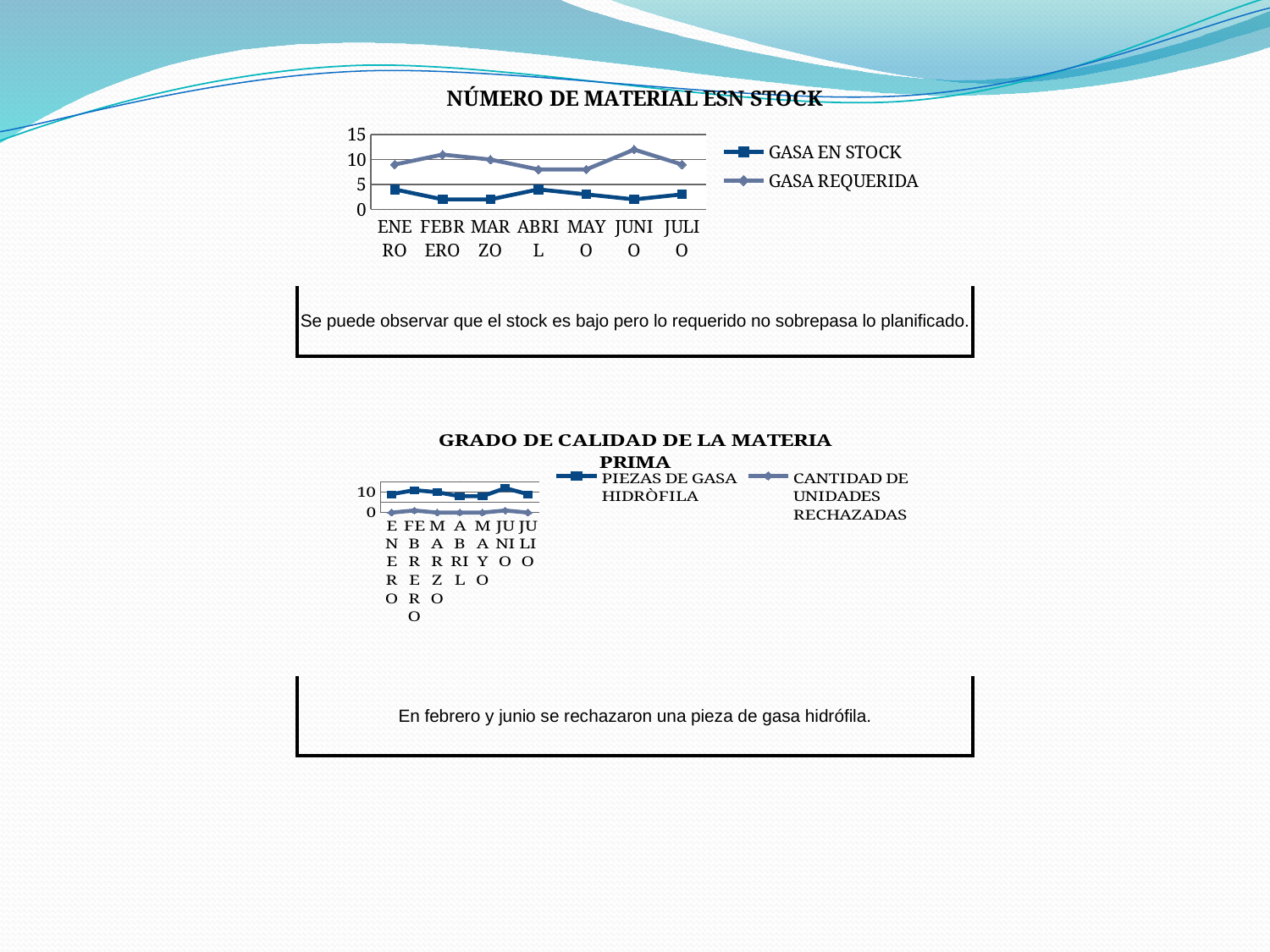
What kind of chart is the top chart titled 'NÚMERO DE MATERIAL ESN STOCK'? Line chart How many series does the legend of the top chart 'NÚMERO DE MATERIAL ESN STOCK' list? 2 In the top chart 'NÚMERO DE MATERIAL ESN STOCK', is the value of GASA EN STOCK in ENERO greater or less than 5? less In the bottom chart 'GRADO DE CALIDAD DE LA MATERIA PRIMA', which series has the larger value in ENERO, PIEZAS DE GASA HIDRÒFILA or CANTIDAD DE UNIDADES RECHAZADAS? PIEZAS DE GASA HIDRÒFILA In the top chart 'NÚMERO DE MATERIAL ESN STOCK', which series has the larger value in ENERO, GASA EN STOCK or GASA REQUERIDA? GASA REQUERIDA What kind of chart is the bottom chart titled 'GRADO DE CALIDAD DE LA MATERIA PRIMA'? Line chart In the top chart 'NÚMERO DE MATERIAL ESN STOCK', is the value of GASA REQUERIDA in JUNIO greater or less than 10? greater How many series does the legend of the bottom chart 'GRADO DE CALIDAD DE LA MATERIA PRIMA' list? 2 In the top chart 'NÚMERO DE MATERIAL ESN STOCK', is the value of GASA REQUERIDA in ABRIL greater or less than 10? less In the top chart 'NÚMERO DE MATERIAL ESN STOCK', in which month is GASA REQUERIDA highest? JUNIO How many months are shown on the x axis of the top chart 'NÚMERO DE MATERIAL ESN STOCK'? 7